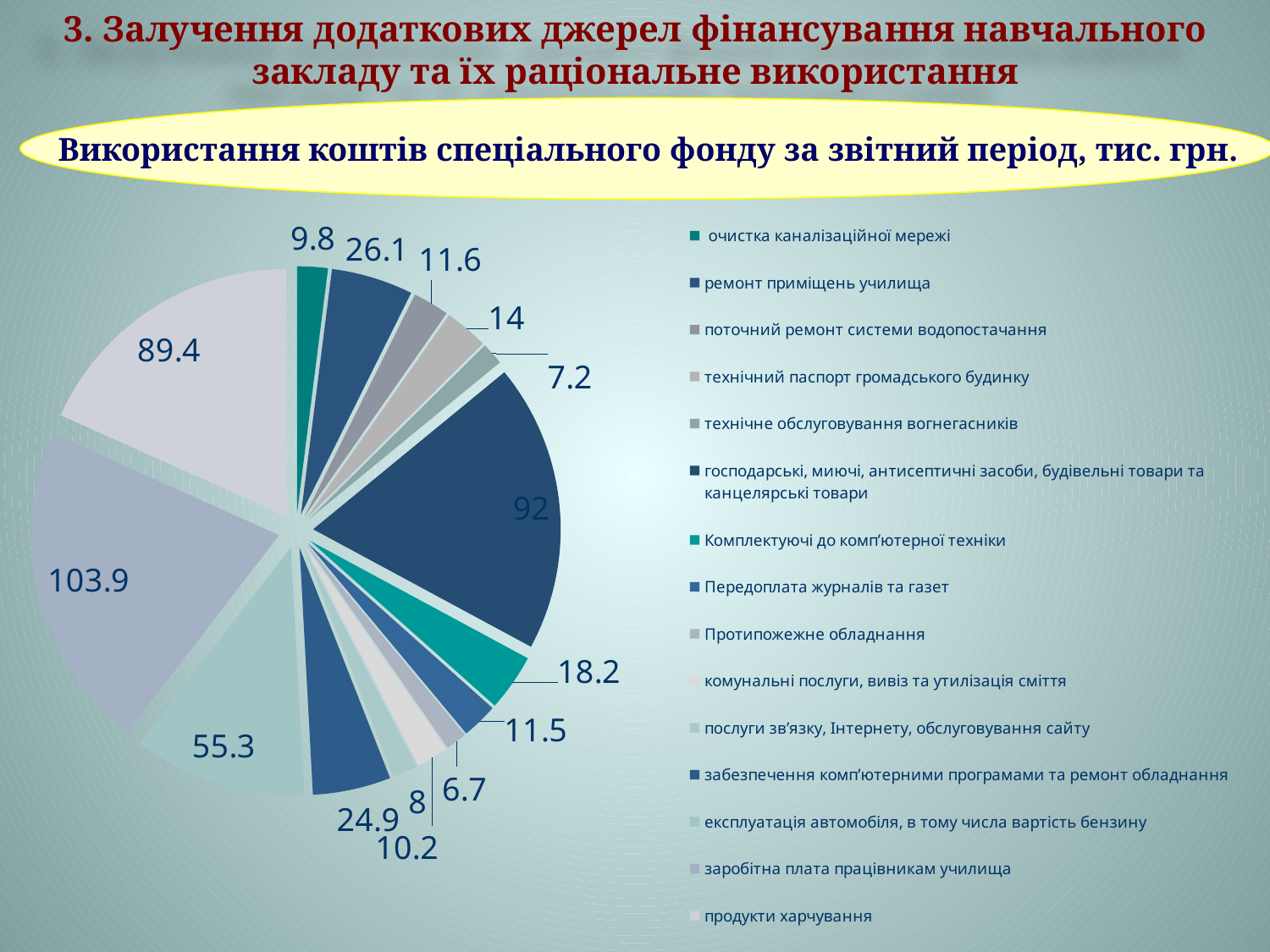
What unit is stated in the chart's title for the values? тис. грн. What is the value for 'господарські, миючі, антисептичні засоби, будівельні товари та канцелярські товари'? 92 Which category has the largest slice of the pie? заробітна плата працівникам училища Which category has the smallest slice of the pie? Протипожежне обладнання What is the value for 'експлуатація автомобіля, в тому числа вартість бензину'? 55.3 What is the value for 'очистка каналізаційної мережі'? 9.8 What is the difference between the values for 'заробітна плата працівникам училища' and 'продукти харчування'? 14.5 How many categories does the legend of the pie chart list? 15 What is the value for 'продукти харчування'? 89.4 What is the value for 'заробітна плата працівникам училища'? 103.9 What kind of chart is shown on the slide? pie chart Which is larger: the value for 'експлуатація автомобіля, в тому числа вартість бензину' or for 'ремонт приміщень училища'? експлуатація автомобіля, в тому числа вартість бензину